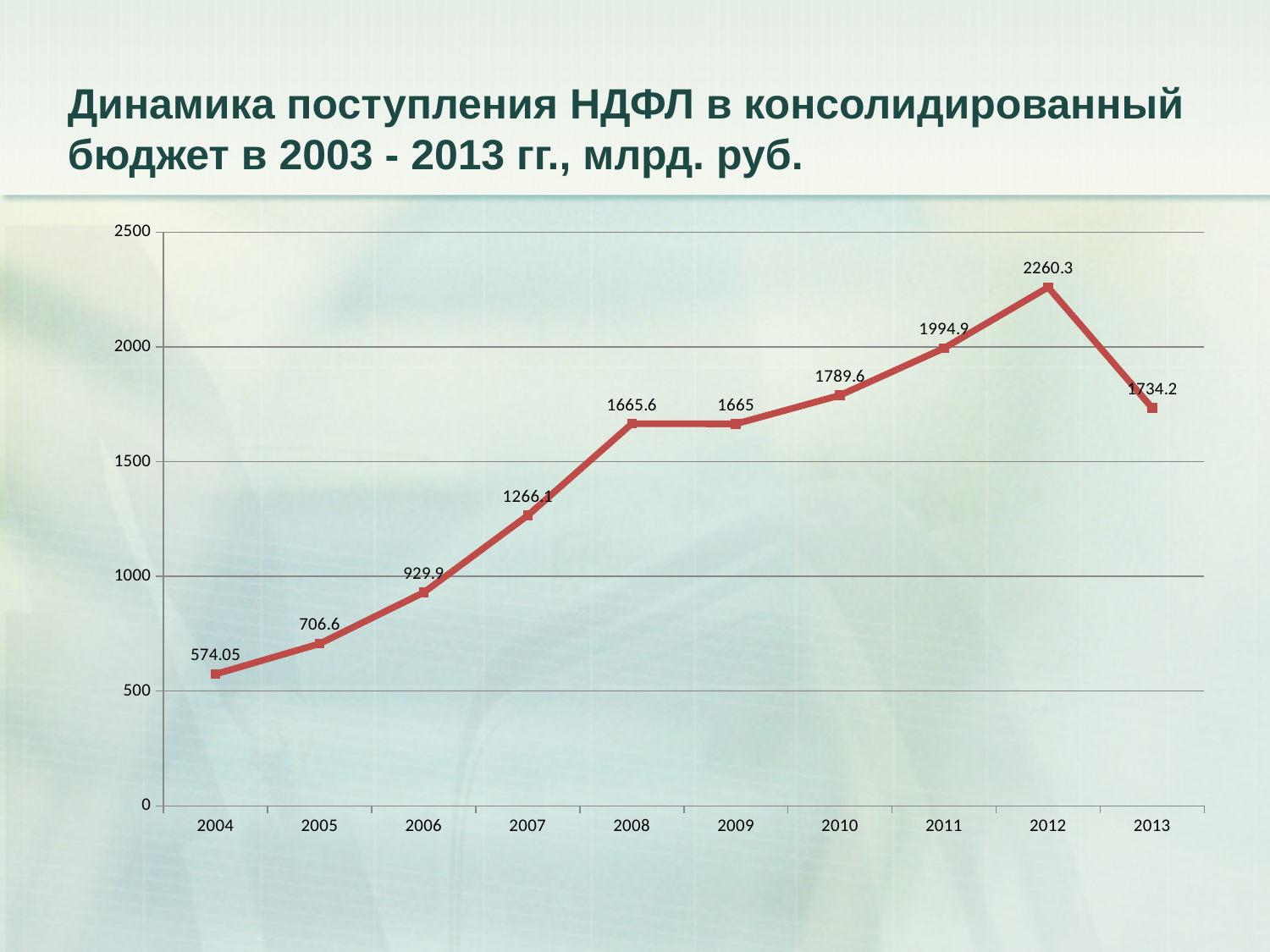
What is the value for 2009? 1665 Is the value for 2011 greater or less than 1500? greater What kind of chart is shown on the slide? line chart What is the value for 2012? 2260.3 What is the value for 2013? 1734.2 What is the difference between the values for 2012 and 2011? 265.4 Which year has the lowest value? 2004 How many years are plotted on the chart? 10 Which is larger, the value for 2007 or the value for 2010? 2010 What is the value for 2004? 574.05 What is the difference between the values for 2012 and 2013? 526.1 Which year has the highest value? 2012